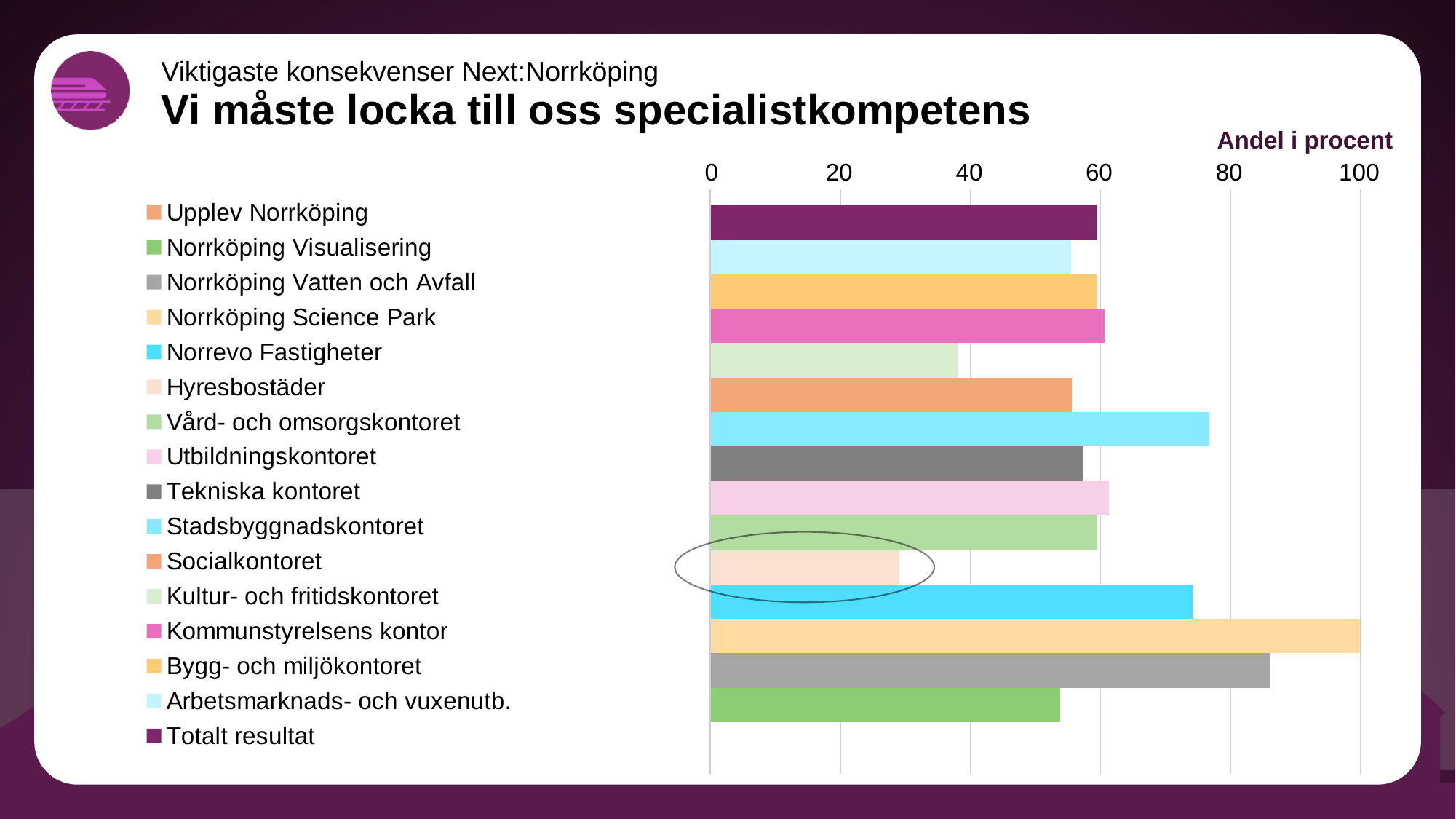
Is the value for Kultur- och fritidskontoret greater or less than 60? less Is the value for Hyresbostäder greater or less than 40? less Which category has the highest value in the chart? Norrköping Science Park Which is larger, the value for Norrköping Vatten och Avfall or the value for Norrevo Fastigheter? Norrköping Vatten och Avfall Is the value for Stadsbyggnadskontoret greater or less than 60? greater How many entries does the chart legend list? 16 Which is larger, the value for Stadsbyggnadskontoret or the value for Hyresbostäder? Stadsbyggnadskontoret What kind of chart is shown on the slide? bar chart What is the axis title shown above the chart's horizontal axis? Andel i procent